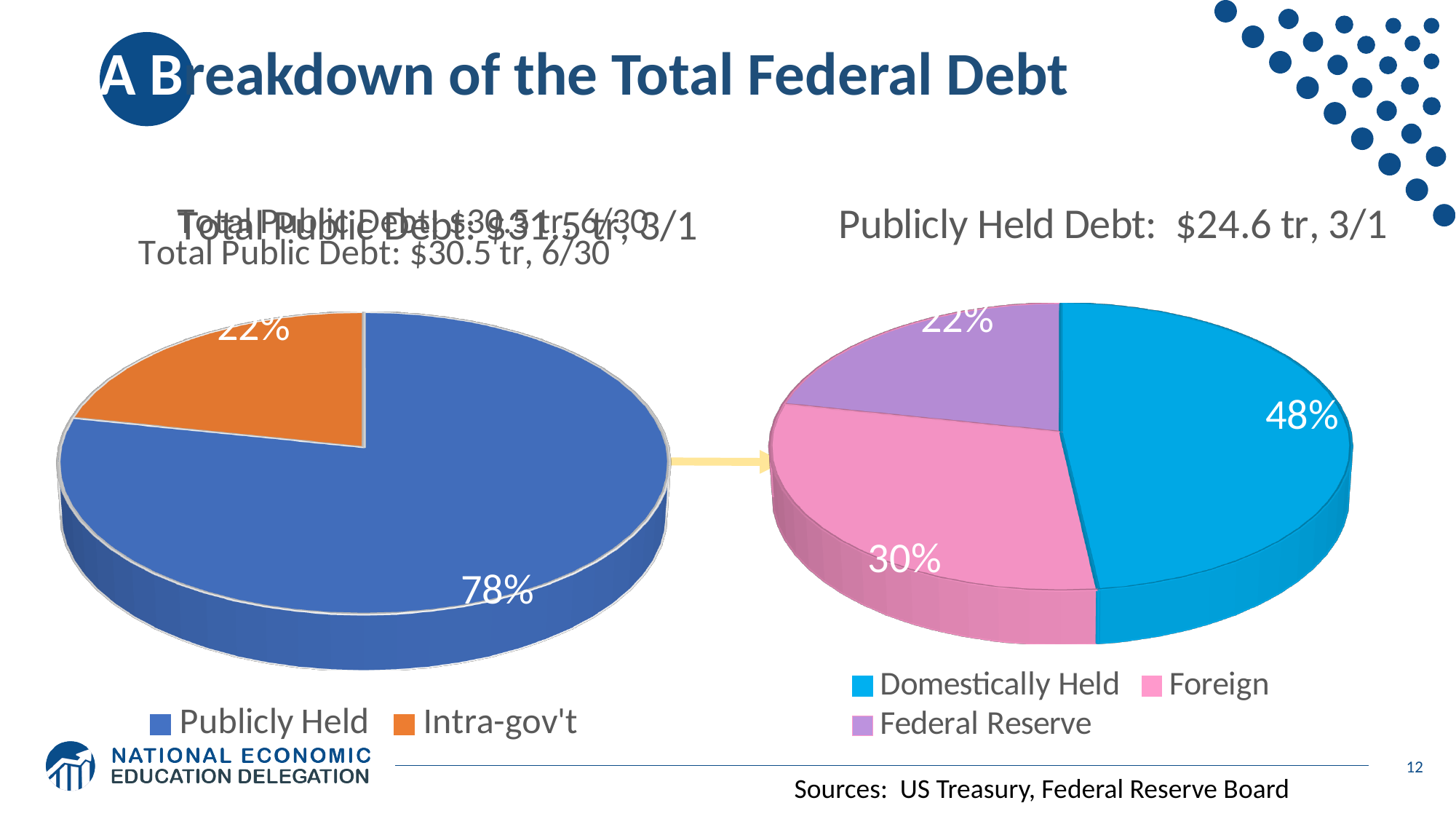
What kind of chart is the left chart on the slide? Pie chart In the 'Publicly Held Debt' pie chart, which is larger: Foreign or Federal Reserve? Foreign In the 'Publicly Held Debt' pie chart, which category has the smallest slice? Federal Reserve In the 'Publicly Held Debt' pie chart, by how many percentage points does Domestically Held exceed Foreign? 18 percentage points How many entries does the legend of the 'Publicly Held Debt' pie chart list? 3 In the 'Publicly Held Debt' pie chart, what percentage is shown for Foreign? 30% In the left pie chart, what percentage is shown for Publicly Held? 78% In the left pie chart, what percentage is shown for Intra-gov't? 22% In the 'Publicly Held Debt' pie chart, what percentage is shown for Domestically Held? 48% How many slices does the left pie chart have? 2 In the 'Publicly Held Debt' pie chart, what percentage is shown for Federal Reserve? 22% In the left pie chart, which category has the largest slice? Publicly Held